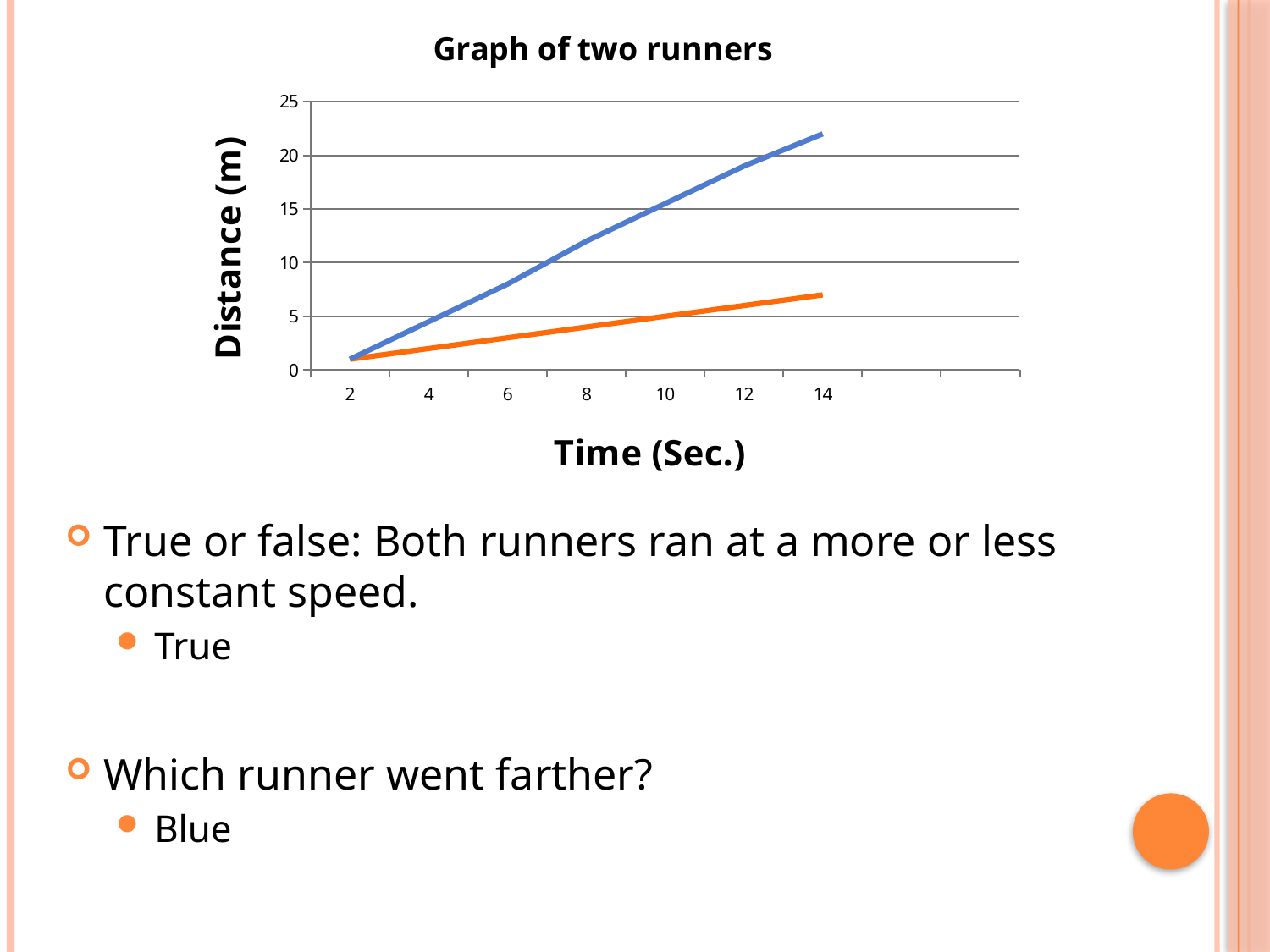
Does the orange line rise or fall as time increases? rise Is the distance for the blue line at time 14 greater or less than 20? greater Is the distance for the blue line at time 8 greater or less than 10? greater Which line reaches the highest distance on the chart, blue or orange? blue What kind of chart is shown on the slide? line chart How many lines are plotted on the chart? 2 Is the distance for the orange line at time 8 greater or less than 5? less At time 14, which line shows the larger distance, blue or orange? blue Does the blue line rise or fall as time increases? rise What is the title of the chart? Graph of two runners What is the label of the vertical axis of the chart? Distance (m)